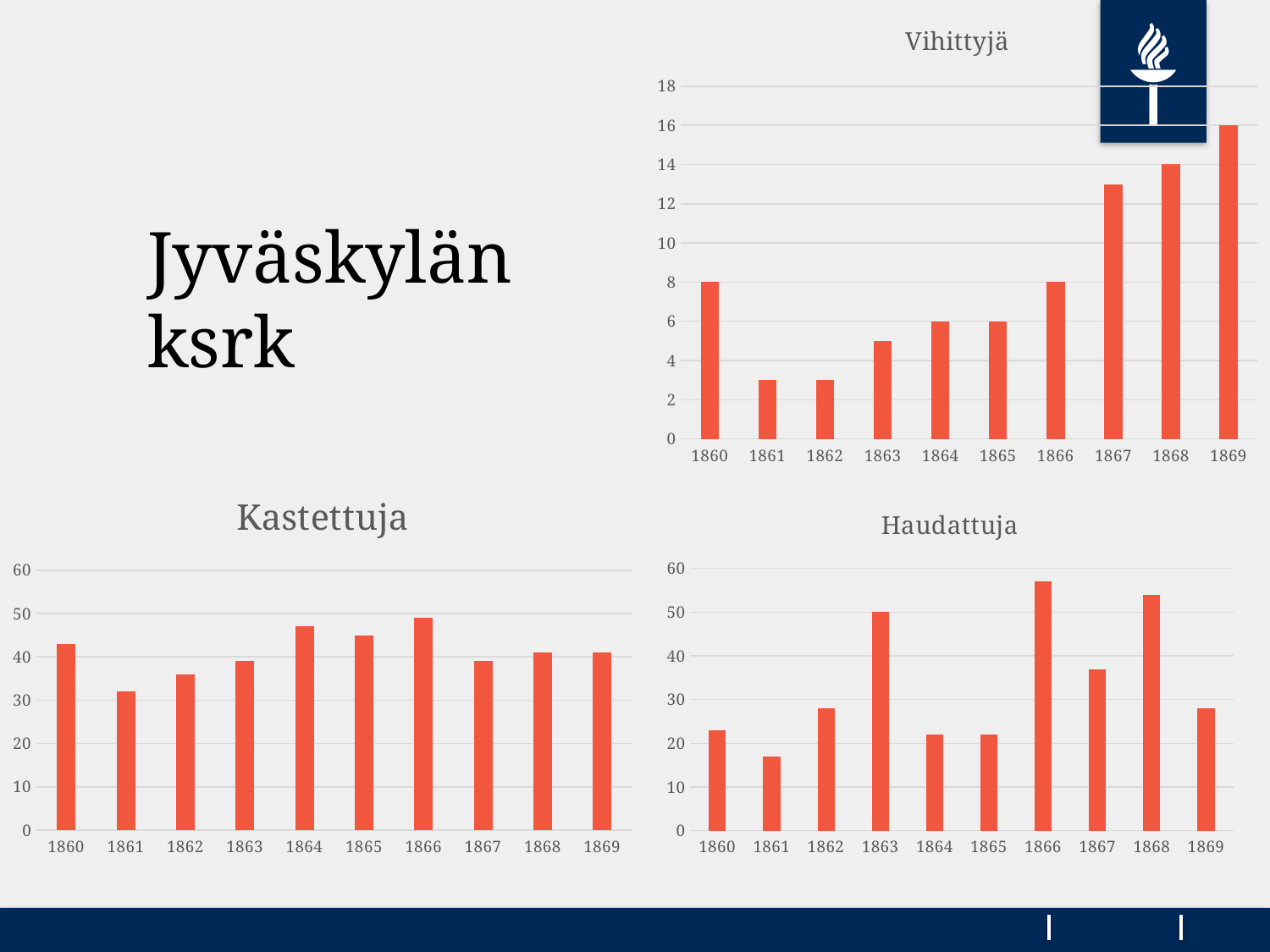
In the Haudattuja chart, which year has the larger value, 1863 or 1864? 1863 In the Vihittyjä chart, how many years are shown on the x axis? 10 In the Vihittyjä chart, what is the value for 1869? 16 In the Kastettuja chart, is the value for 1860 greater or less than 40? greater What kind of chart is the Vihittyjä chart? bar chart In the Haudattuja chart, which year has the lowest value? 1861 In the Kastettuja chart, which year has the lowest value? 1861 In the Vihittyjä chart, do the values generally rise or fall from 1862 to 1869? rise In the Vihittyjä chart, which year has the highest value? 1869 In the Haudattuja chart, what is the value for 1863? 50 In the Vihittyjä chart, what is the value for 1860? 8 In the Vihittyjä chart, what is the difference between the values for 1869 and 1860? 8